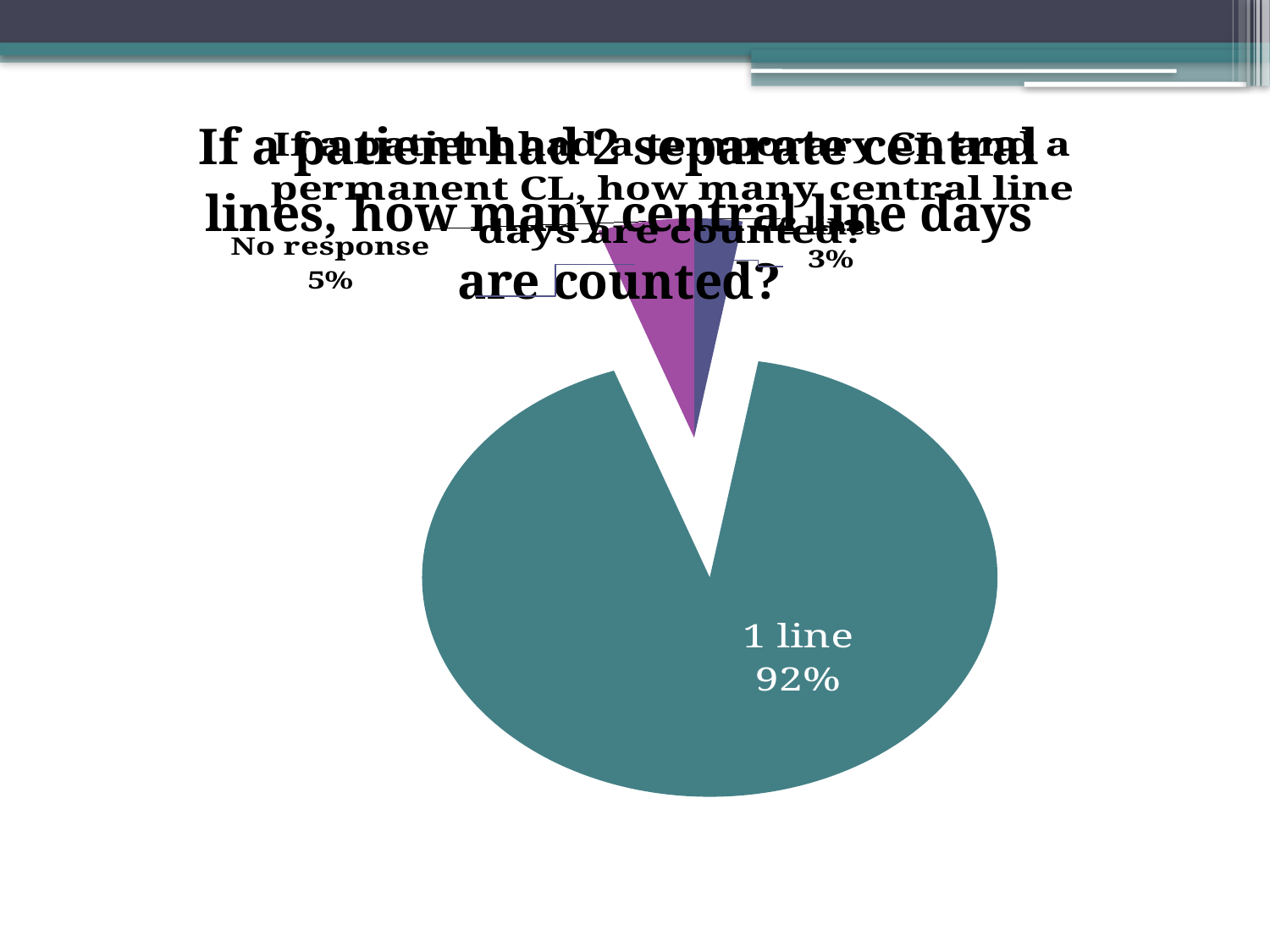
What do the three slice percentages add up to? 100% What is the smallest percentage shown on the pie chart? 3% What percentage is shown for "No response"? 5% What is the difference in percentage points between the "1 line" slice and the "No response" slice? 87 Which is larger, the "1 line" slice or the "No response" slice? 1 line What kind of chart is shown on the slide? pie chart Is the "1 line" slice greater or less than 50% of the pie? greater What colour is the "1 line" slice? teal What percentage of the pie is the "1 line" slice? 92% How many slices does the pie chart have? 3 Which category has the largest slice of the pie? 1 line